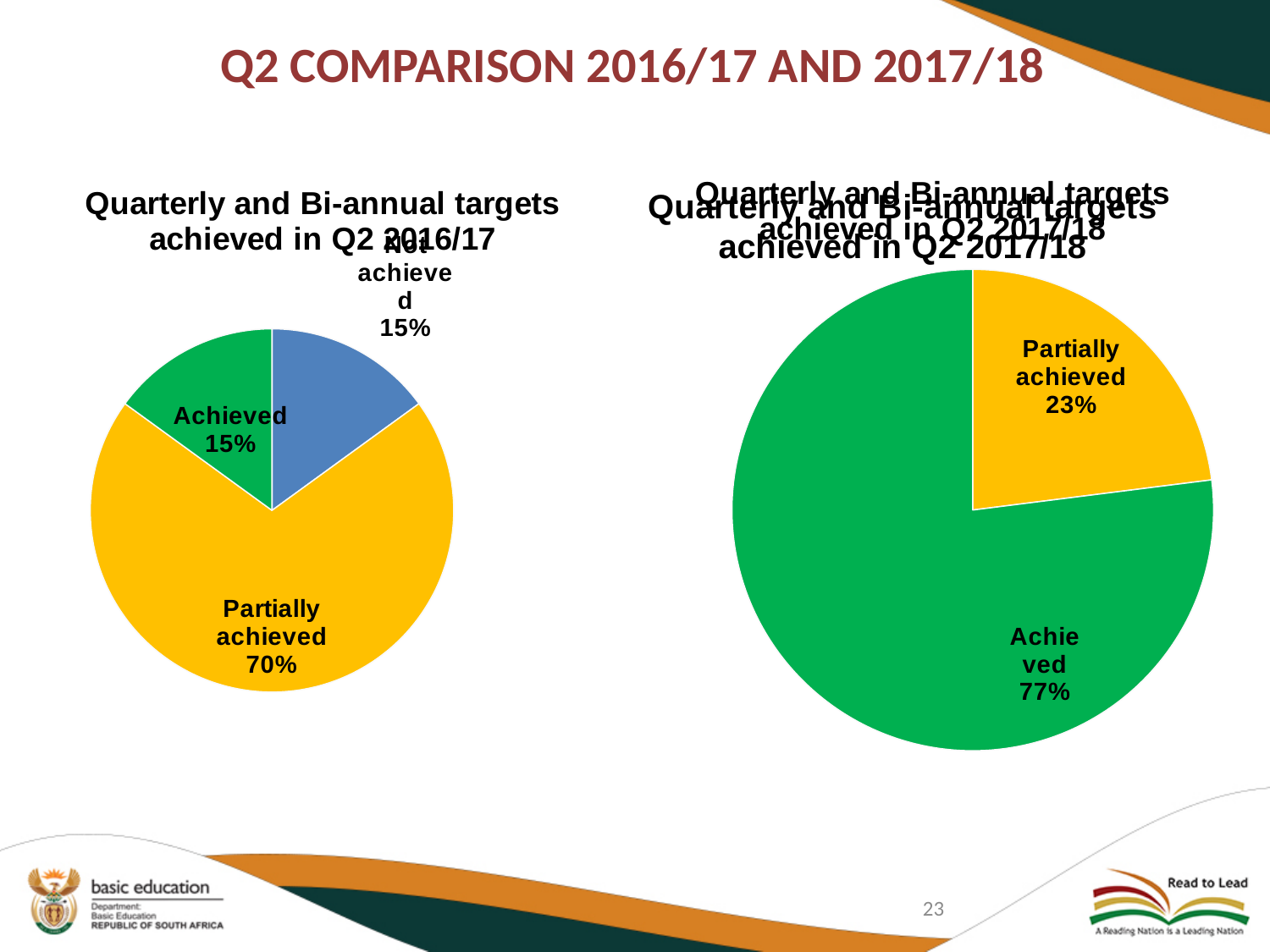
In the 'Quarterly and Bi-annual targets achieved in Q2 2016/17' chart, what share is Not achieved? 15% How many slices does the 'Quarterly and Bi-annual targets achieved in Q2 2017/18' chart have? 2 In the 'Quarterly and Bi-annual targets achieved in Q2 2016/17' chart, what share is Partially achieved? 70% In the 'Quarterly and Bi-annual targets achieved in Q2 2016/17' chart, which category has the largest slice? Partially achieved What type of chart is the 'Quarterly and Bi-annual targets achieved in Q2 2017/18' chart? Pie chart In the 'Quarterly and Bi-annual targets achieved in Q2 2017/18' chart, which category has the smallest slice? Partially achieved How many slices does the 'Quarterly and Bi-annual targets achieved in Q2 2016/17' chart have? 3 In the 'Quarterly and Bi-annual targets achieved in Q2 2017/18' chart, what share is Achieved? 77% In the 'Quarterly and Bi-annual targets achieved in Q2 2017/18' chart, what is the difference between the Achieved and Partially achieved shares? 54% In the 'Quarterly and Bi-annual targets achieved in Q2 2017/18' chart, what share is Partially achieved? 23% In the 'Quarterly and Bi-annual targets achieved in Q2 2016/17' chart, what share is Achieved? 15% Which chart shows a larger Achieved share, the Q2 2016/17 chart or the Q2 2017/18 chart? Q2 2017/18